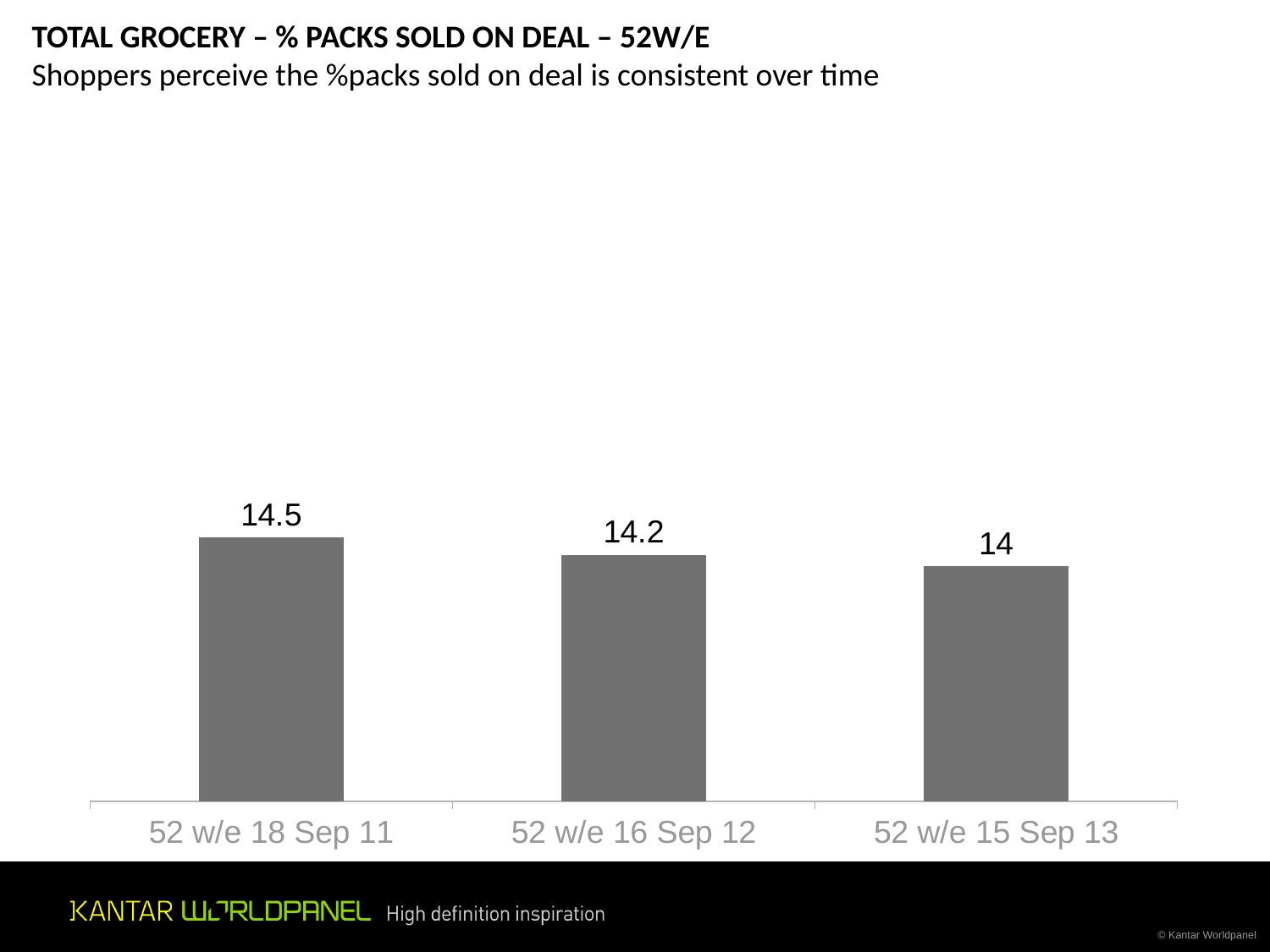
Which period has the lowest value? 52 w/e 15 Sep 13 What is the difference between the values for 52 w/e 18 Sep 11 and 52 w/e 16 Sep 12? 0.3 How many periods are shown on the chart? 3 Which is larger, the value for 52 w/e 16 Sep 12 or 52 w/e 15 Sep 13? 52 w/e 16 Sep 12 What is the value for 52 w/e 15 Sep 13? 14 Which period has the highest value? 52 w/e 18 Sep 11 What is the difference between the values for 52 w/e 18 Sep 11 and 52 w/e 15 Sep 13? 0.5 What is the value for 52 w/e 16 Sep 12? 14.2 What kind of chart is shown on the slide? Bar chart What is the value for 52 w/e 18 Sep 11? 14.5 Do the values rise or fall from 52 w/e 18 Sep 11 to 52 w/e 15 Sep 13? Fall What is the title of the chart on the slide? TOTAL GROCERY – % PACKS SOLD ON DEAL – 52W/E